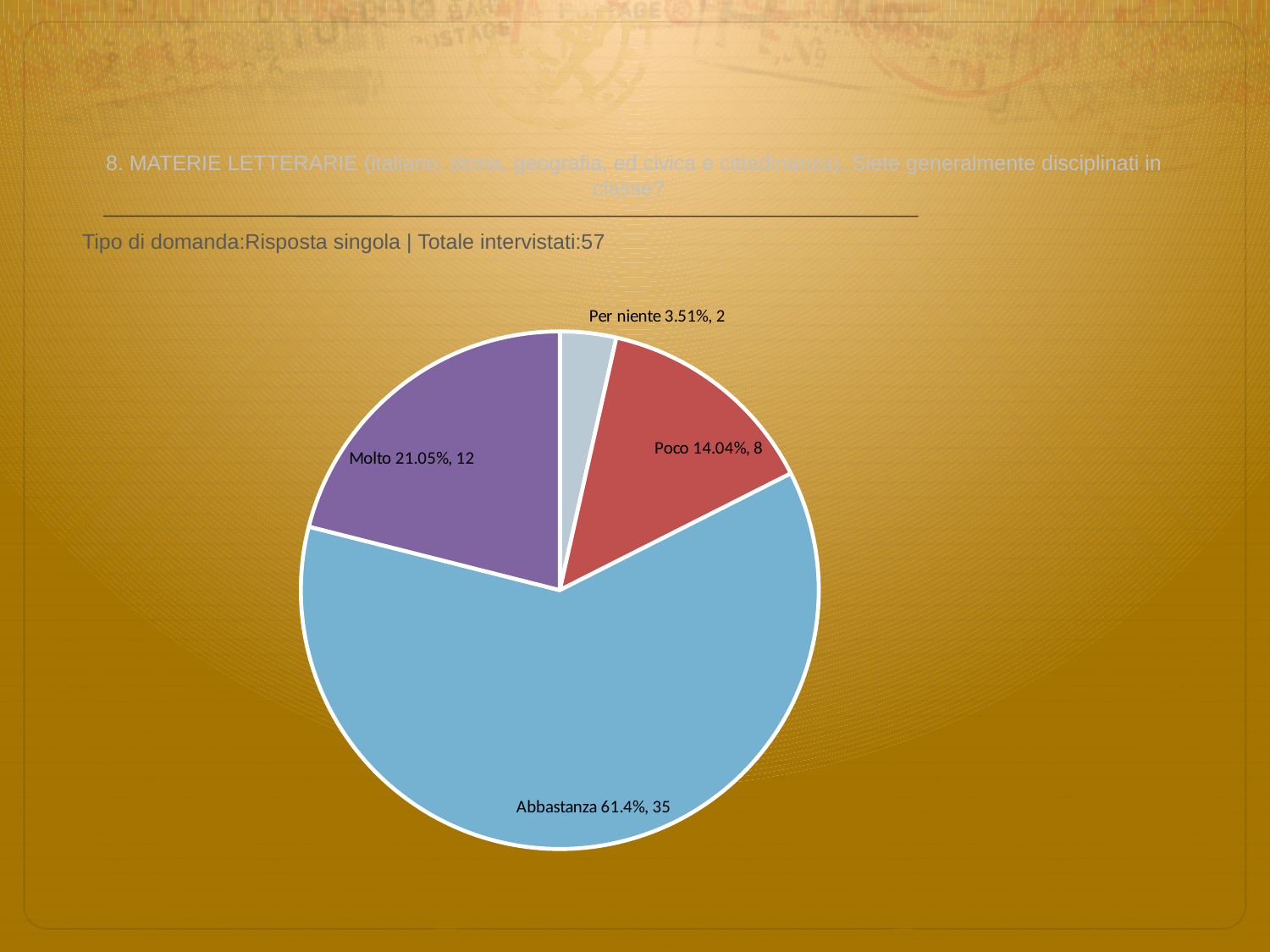
Which has more respondents, Poco or Molto? Molto What percentage share does the Per niente slice have? 3.51% What is the difference in respondent count between Abbastanza and Molto? 23 What colour is the Abbastanza slice? light blue How many respondents answered Poco? 8 What kind of chart is shown on the slide? pie chart What percentage share does the Molto slice have? 21.05% What percentage share does the Abbastanza slice have? 61.4% Which category has the largest slice of the pie? Abbastanza How many respondents answered Molto? 12 Which category has the smallest slice of the pie? Per niente How many slices does the pie chart have? 4